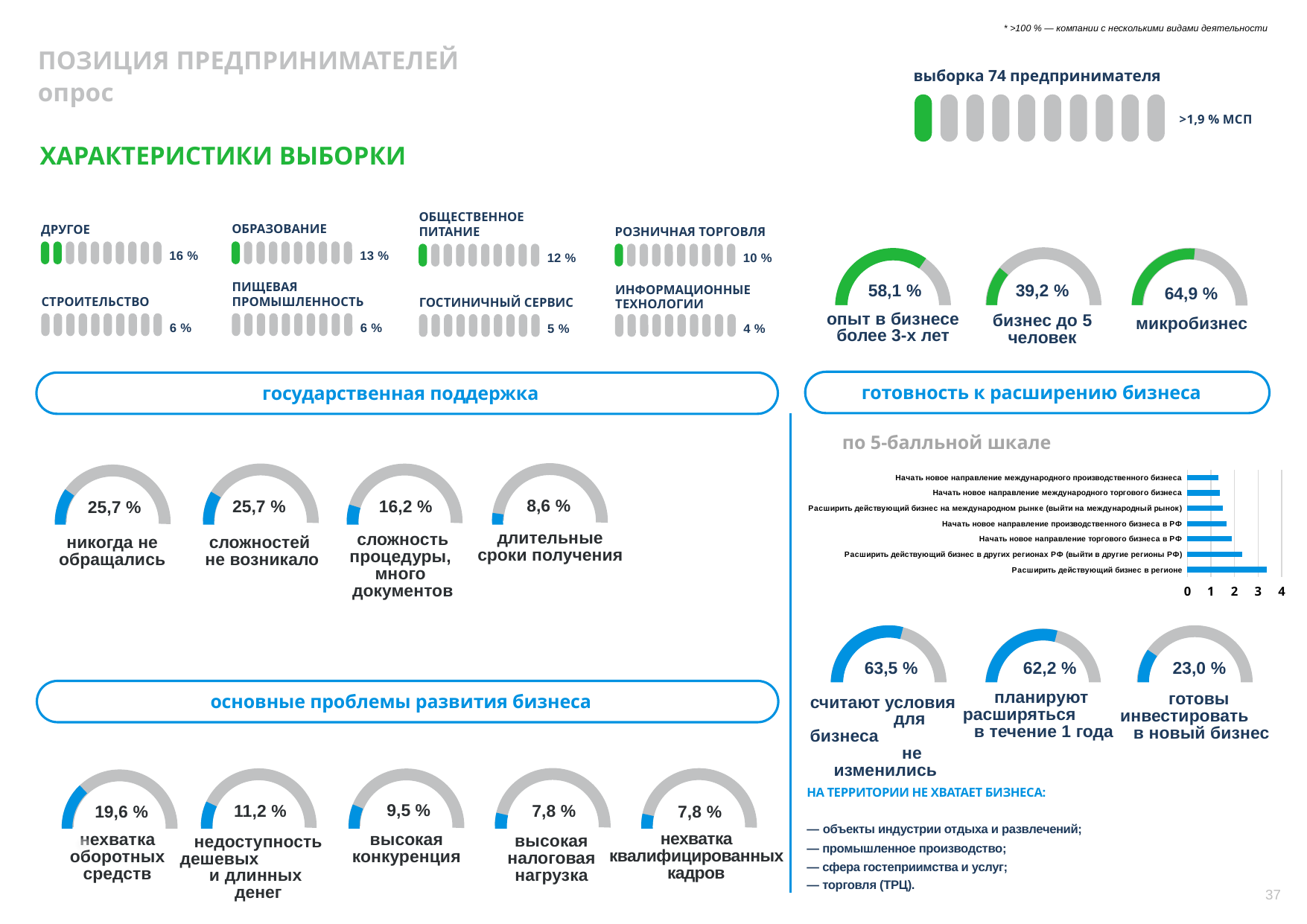
In the 'основные проблемы развития бизнеса' section, what is the value for 'нехватка оборотных средств'? 19,6 % In the bar chart 'по 5-балльной шкале', is the value for 'Расширить действующий бизнес в других регионах РФ (выйти в другие регионы РФ)' greater or less than 2? greater In the bar chart 'по 5-балльной шкале', is the value for 'Начать новое направление международного производственного бизнеса' greater or less than 2? less In the bar chart 'по 5-балльной шкале', which category has the highest value? Расширить действующий бизнес в регионе In the 'готовность к расширению бизнеса' section, what percentage are ready to invest in a new business ('готовы инвестировать в новый бизнес')? 23,0 % What kind of chart is shown under the heading 'по 5-балльной шкале'? bar chart How many categories does the bar chart 'по 5-балльной шкале' show? 7 In the bar chart 'по 5-балльной шкале', is the value for 'Расширить действующий бизнес в регионе' greater or less than 3? greater In the 'готовность к расширению бизнеса' section, what percentage of respondents plan to expand within 1 year ('планируют расширяться в течение 1 года')? 62,2 % In the bar chart 'по 5-балльной шкале', which is larger: the value for 'Расширить действующий бизнес в регионе' or for 'Начать новое направление международного торгового бизнеса'? Расширить действующий бизнес в регионе In the 'характеристики выборки' section, what is the difference between the share for 'микробизнес' and the share for 'бизнес до 5 человек'? 25,7 % What is the maximum value shown on the axis of the bar chart 'по 5-балльной шкале'? 4